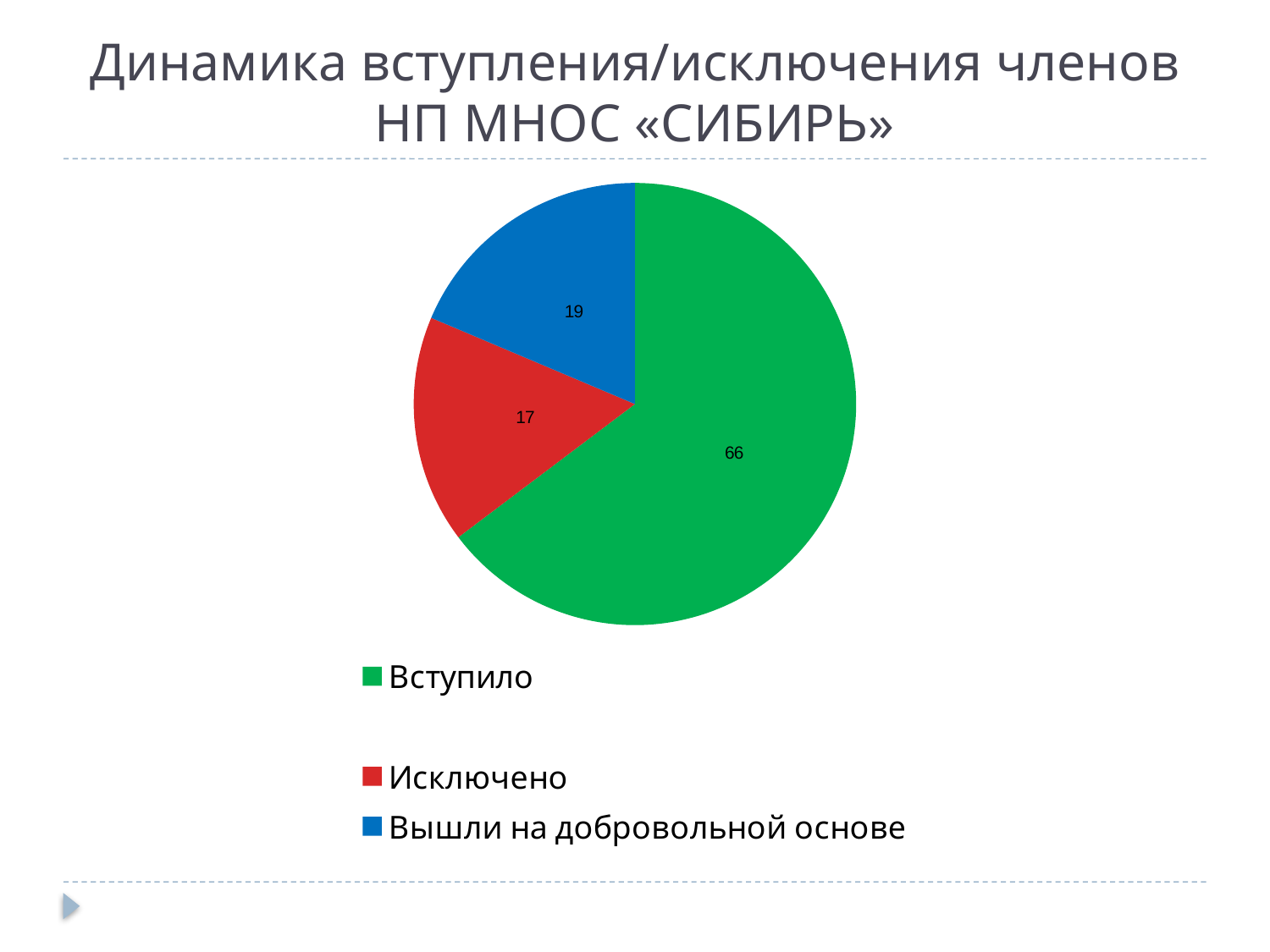
Which category has the largest slice of the pie? Вступило What colour is the Исключено slice? Red How many entries does the legend list? 3 What is the difference between the Вышли на добровольной основе value and the Исключено value? 2 How many slices does the pie chart have? 3 What value is shown for the Вышли на добровольной основе slice? 19 What value is shown for the Исключено slice? 17 Which is larger, the value for Вступило or the value for Вышли на добровольной основе? Вступило What value is shown for the Вступило slice? 66 What is the difference between the Вступило value and the Исключено value? 49 What kind of chart is shown on the slide? Pie chart Which category has the smallest slice of the pie? Исключено